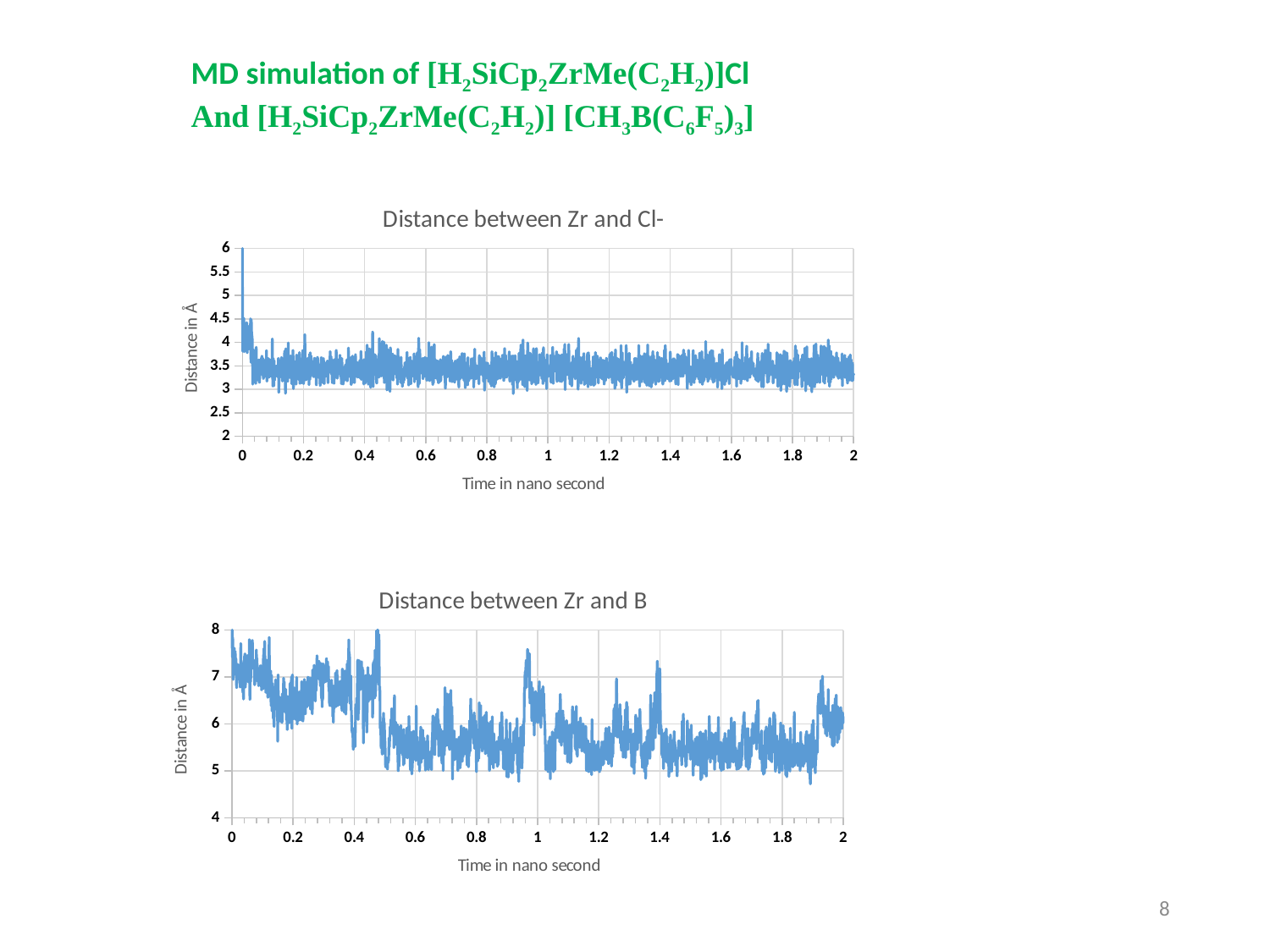
In the 'Distance between Zr and B' chart, what is the label of the y axis? Distance in Å What kind of chart is the 'Distance between Zr and Cl-' chart? line chart What kind of chart is the 'Distance between Zr and B' chart? line chart In the 'Distance between Zr and B' chart, does the distance overall rise or fall from time 0 to time 2? fall In the 'Distance between Zr and B' chart, is the distance at time 1.6 greater or less than 7? less In the 'Distance between Zr and Cl-' chart, is the distance at time 1.4 greater or less than 2.5? greater How many data series are plotted in the 'Distance between Zr and B' chart? 1 In the 'Distance between Zr and Cl-' chart, what is the label of the x axis? Time in nano second In the 'Distance between Zr and Cl-' chart, is the distance at time 1 greater or less than 4.5? less At time 1.6, is the distance larger in the 'Distance between Zr and Cl-' chart or the 'Distance between Zr and B' chart? Distance between Zr and B In the 'Distance between Zr and Cl-' chart, does the distance rise or fall during the first 0.05 nano seconds? fall